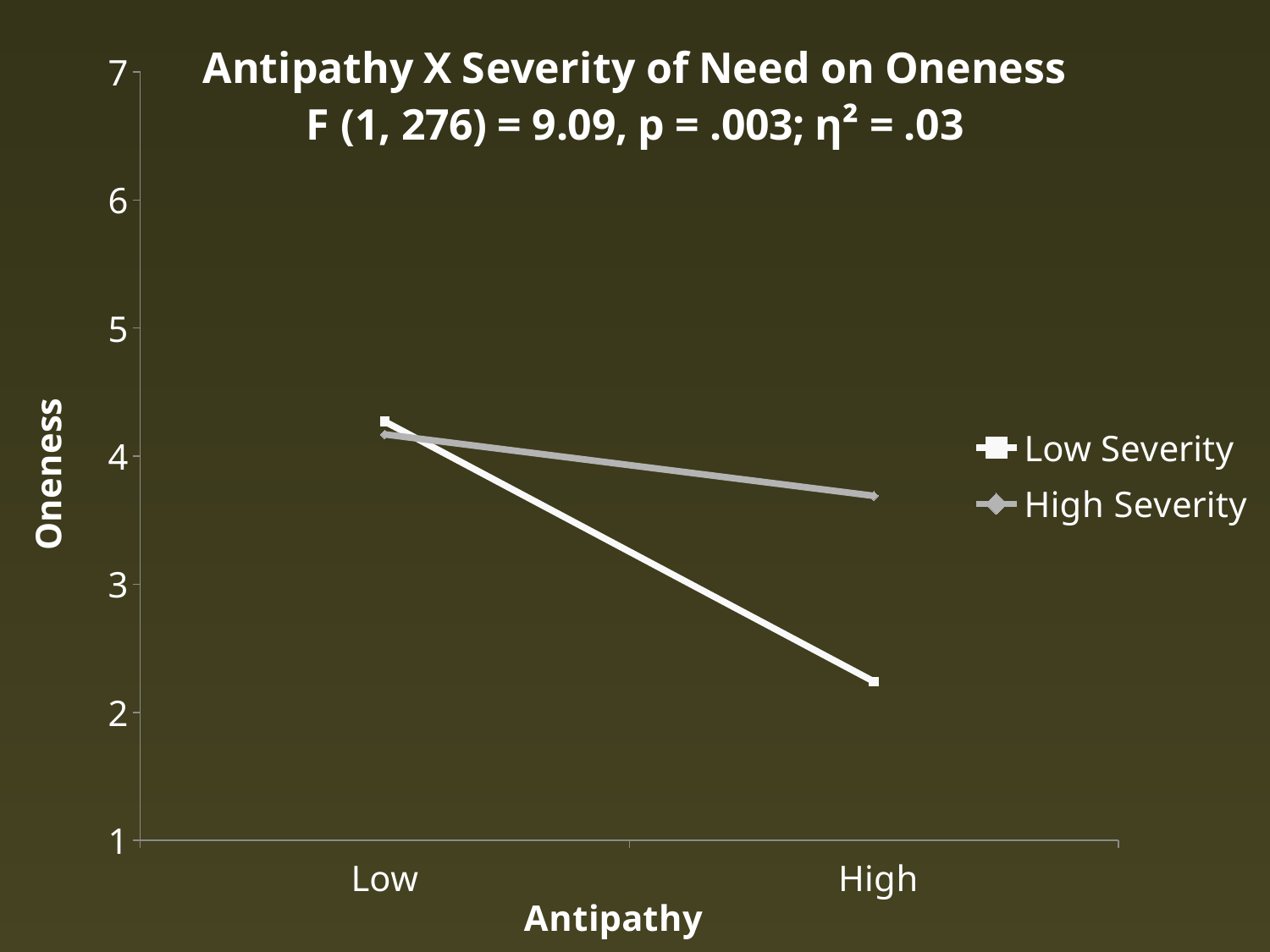
How many categories are shown on the x axis? 2 Which series shows the steeper decline from Low to High antipathy? Low Severity What kind of chart is shown on the slide? line chart Is the High Severity value at High antipathy greater or less than 3? greater Is the Low Severity value at Low antipathy greater or less than 4? greater Does the High Severity line rise or fall from Low to High antipathy? fall Is the Low Severity value at High antipathy greater or less than 3? less At High antipathy, which series has the larger Oneness value, Low Severity or High Severity? High Severity What is the label of the y axis? Oneness How many series does the legend list? 2 Does the Low Severity line rise or fall from Low to High antipathy? fall